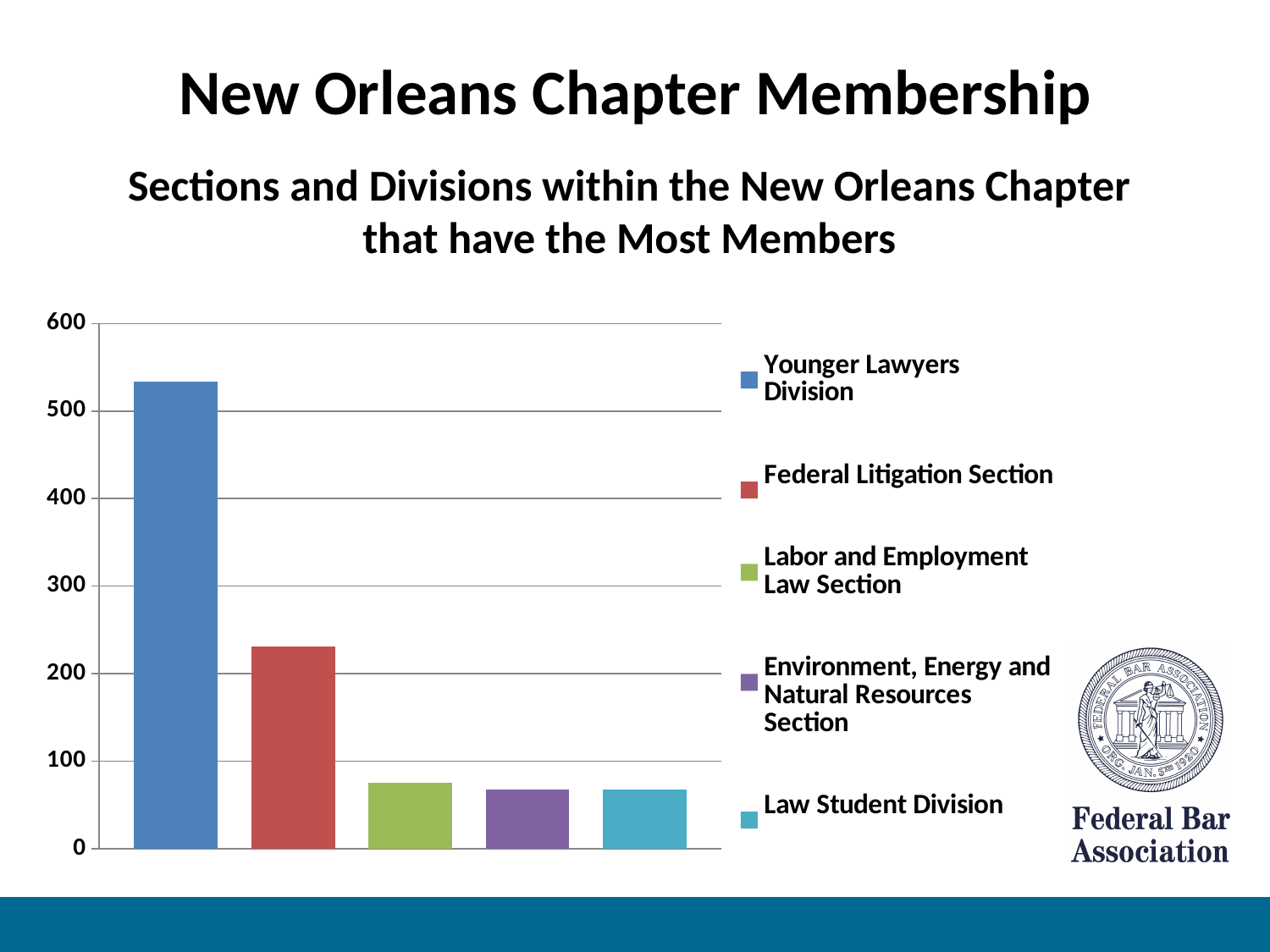
What kind of chart is shown on the slide? bar chart How many bars are plotted in the chart? 5 Which section or division has the highest number of members? Younger Lawyers Division Is the value for the Federal Litigation Section greater or less than 300? less What colour is the bar for the Federal Litigation Section? red Is the value for the Federal Litigation Section greater or less than 200? greater Which has more members, the Federal Litigation Section or the Labor and Employment Law Section? Federal Litigation Section Is the value for the Labor and Employment Law Section greater or less than 100? less Which has more members, the Younger Lawyers Division or the Federal Litigation Section? Younger Lawyers Division How many entries does the legend list? 5